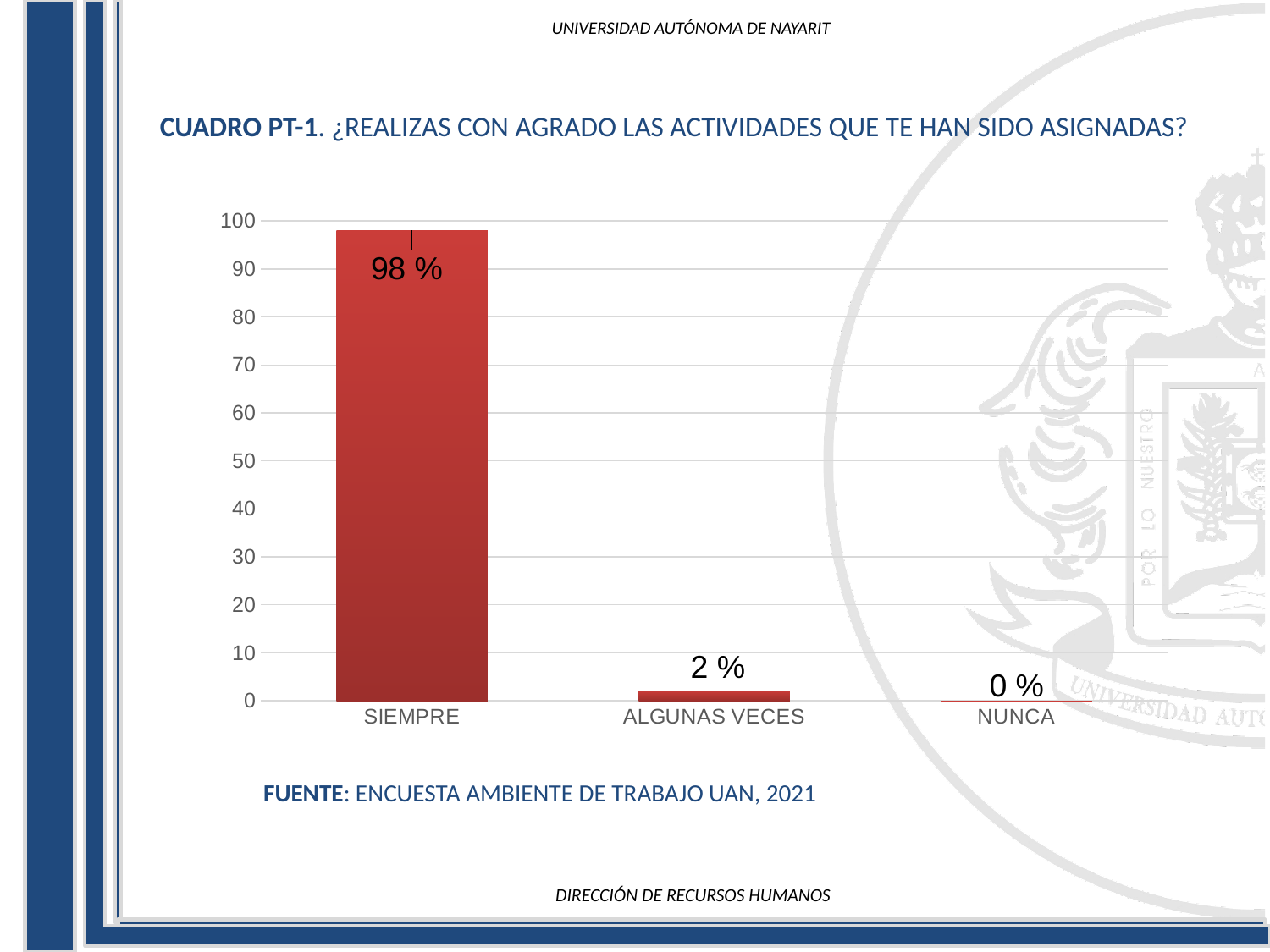
Is the value for ALGUNAS VECES greater or less than 10? less What kind of chart is shown on the slide? bar chart Which category has the lowest value? NUNCA Which is larger, the value for ALGUNAS VECES or the value for NUNCA? ALGUNAS VECES What is the value for NUNCA? 0 % How many categories are shown on the x axis? 3 What is the value for ALGUNAS VECES? 2 % Is the value for SIEMPRE greater or less than 90? greater What is the value for SIEMPRE? 98 % Which category has the highest value? SIEMPRE What source is cited below the chart? ENCUESTA AMBIENTE DE TRABAJO UAN, 2021 What is the difference between the values for SIEMPRE and ALGUNAS VECES? 96 %